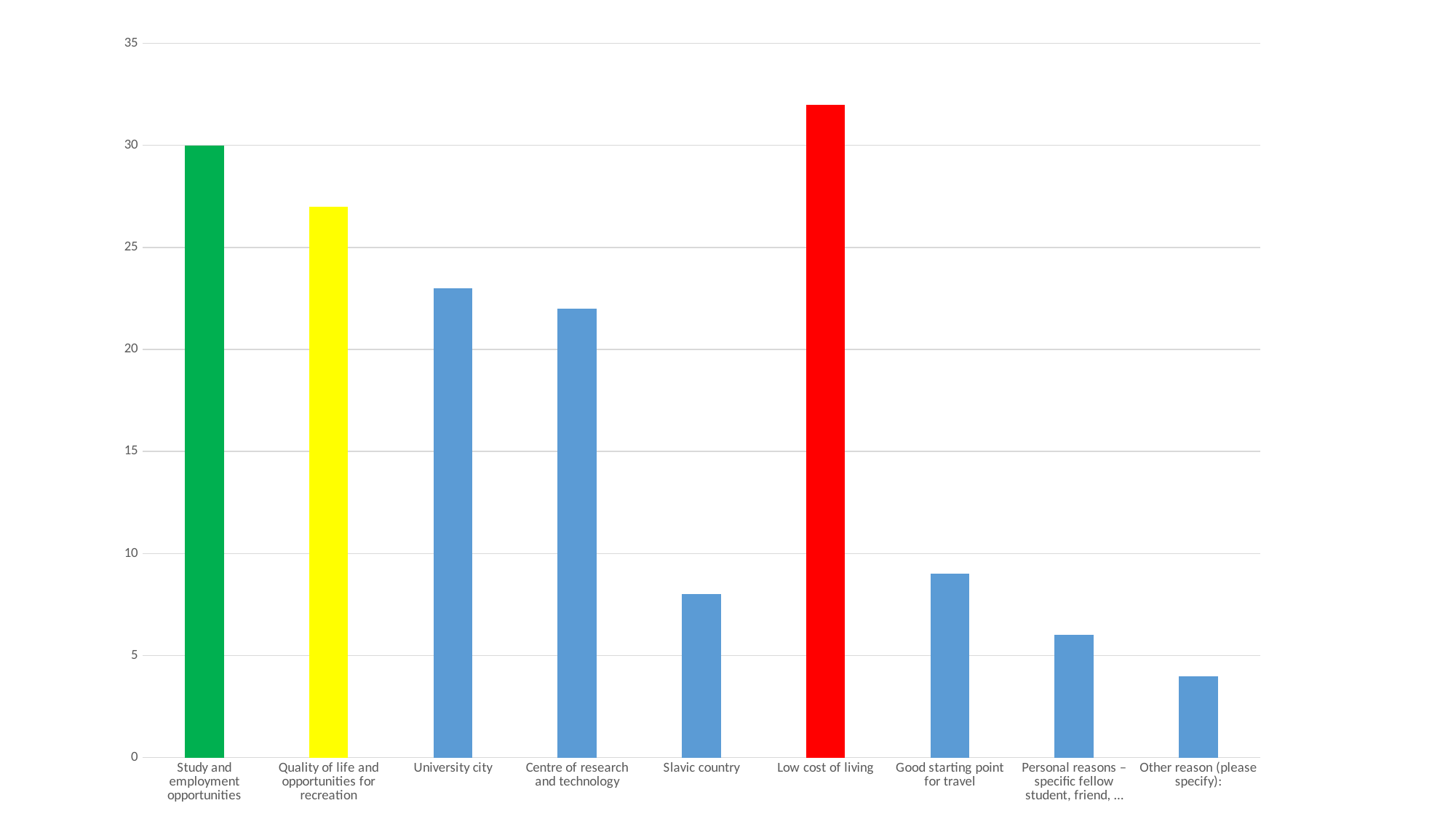
Which is larger, the value for Personal reasons – specific fellow student, friend, … or the value for Other reason (please specify):? Personal reasons – specific fellow student, friend, … What colour is the bar for Low cost of living? Red Is the value for Low cost of living greater or less than 30? greater Is the value for Quality of life and opportunities for recreation greater or less than 25? greater How many categories are shown on the x axis of the chart? 9 Is the value for Slavic country greater or less than 10? less What is the value for Study and employment opportunities? 30 What kind of chart is shown on the slide? Bar chart Which category has the lowest bar in the chart? Other reason (please specify): Which is larger, the value for Quality of life and opportunities for recreation or the value for Centre of research and technology? Quality of life and opportunities for recreation Which category has the highest bar in the chart? Low cost of living